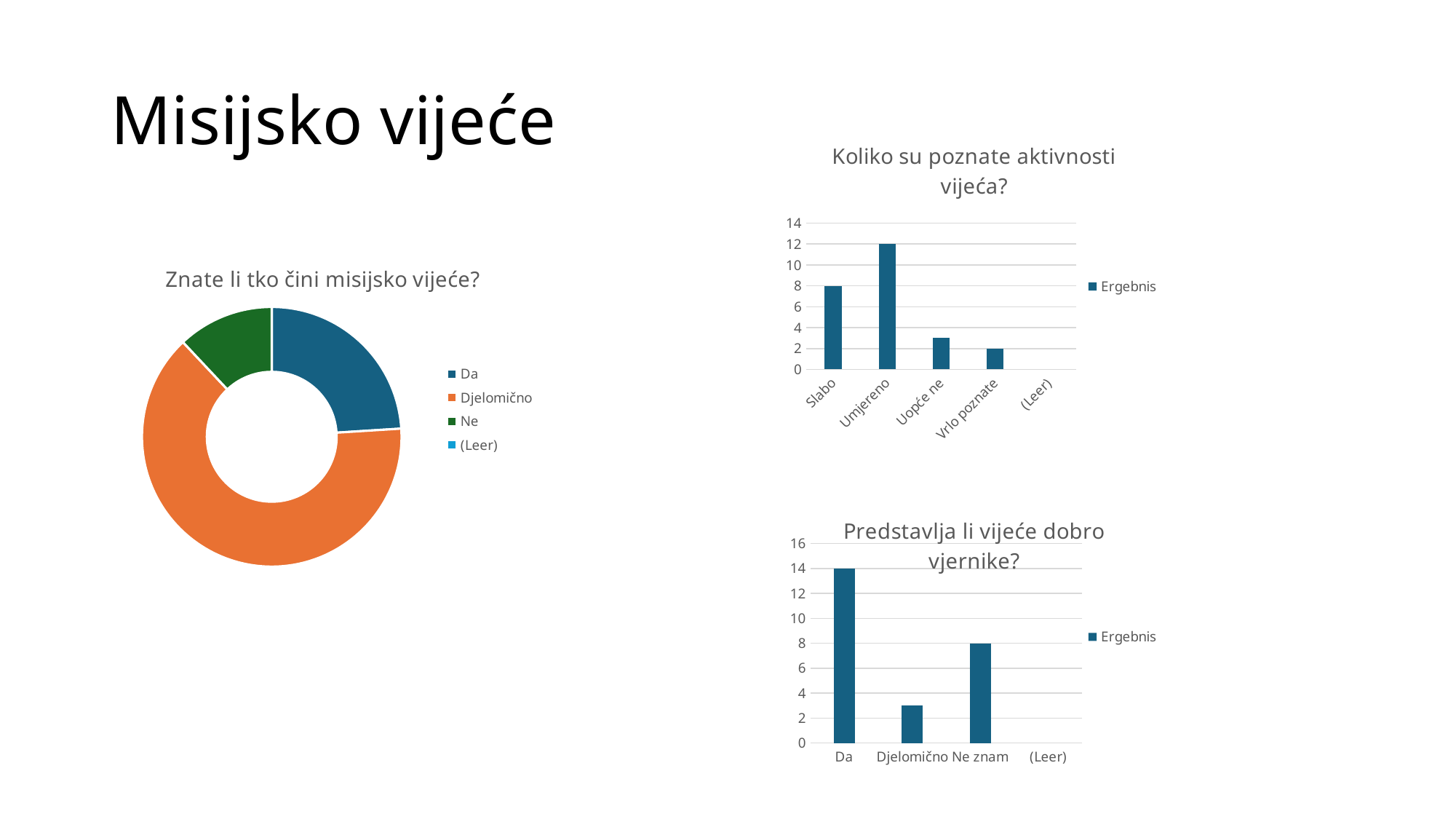
In the chart 'Predstavlja li vijeće dobro vjernike?', how many categories are shown on the x axis? 4 In the chart 'Predstavlja li vijeće dobro vjernike?', is the value for Djelomično greater or less than 2? greater In the chart 'Znate li tko čini misijsko vijeće?', which category has the largest slice? Djelomično In the chart 'Koliko su poznate aktivnosti vijeća?', what is the value for Slabo? 8 In the chart 'Koliko su poznate aktivnosti vijeća?', what is the value for Umjereno? 12 What kind of chart is 'Znate li tko čini misijsko vijeće?'? Doughnut chart In the chart 'Koliko su poznate aktivnosti vijeća?', what is the difference between the values for Umjereno and Slabo? 4 In the chart 'Predstavlja li vijeće dobro vjernike?', what is the value for Ne znam? 8 In the chart 'Koliko su poznate aktivnosti vijeća?', which category has the highest value? Umjereno In the chart 'Predstavlja li vijeće dobro vjernike?', what is the difference between the values for Da and Ne znam? 6 In the chart 'Koliko su poznate aktivnosti vijeća?', is the value for Uopće ne greater or less than 4? less In the chart 'Predstavlja li vijeće dobro vjernike?', what is the value for Da? 14